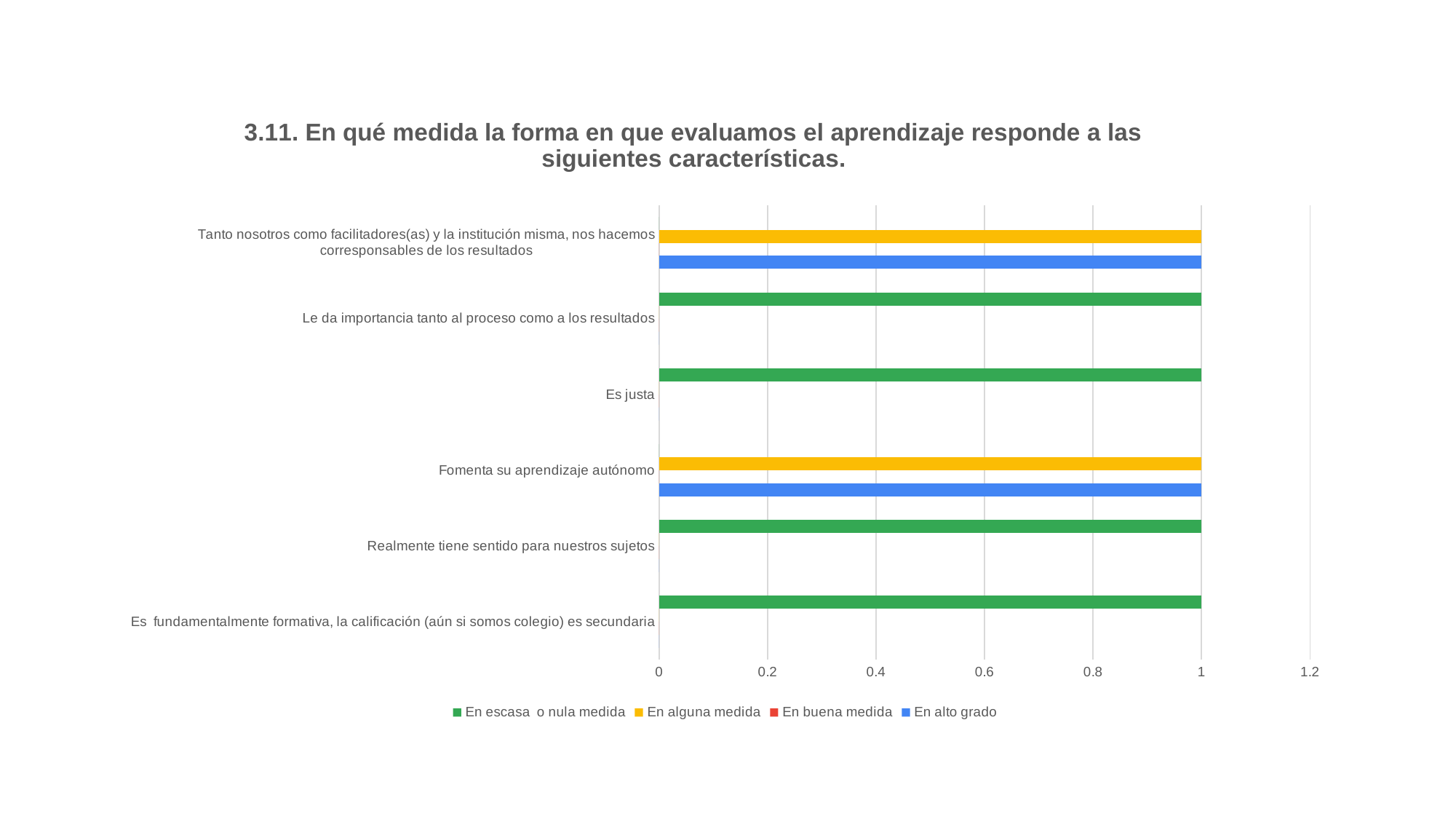
How many series does the legend list? 4 What is the value of 'En escasa o nula medida' for 'Le da importancia tanto al proceso como a los resultados'? 1 What is the value of 'En escasa o nula medida' for 'Realmente tiene sentido para nuestros sujetos'? 1 What is the value of 'En alto grado' for 'Fomenta su aprendizaje autónomo'? 1 What is the value of 'En escasa o nula medida' for 'Es justa'? 1 What is the highest value shown on the horizontal axis? 1.2 What is the value of 'En alguna medida' for 'Tanto nosotros como facilitadores(as) y la institución misma, nos hacemos corresponsables de los resultados'? 1 Is the value of 'En escasa o nula medida' for 'Es fundamentalmente formativa, la calificación (aún si somos colegio) es secundaria' greater or less than 0.8? greater Which series is shown in green in the legend? En escasa o nula medida What kind of chart is shown on the slide? bar chart What is the difference between the 'En alguna medida' value and the 'En alto grado' value for 'Fomenta su aprendizaje autónomo'? 0 How many categories are listed on the vertical axis of the chart? 6